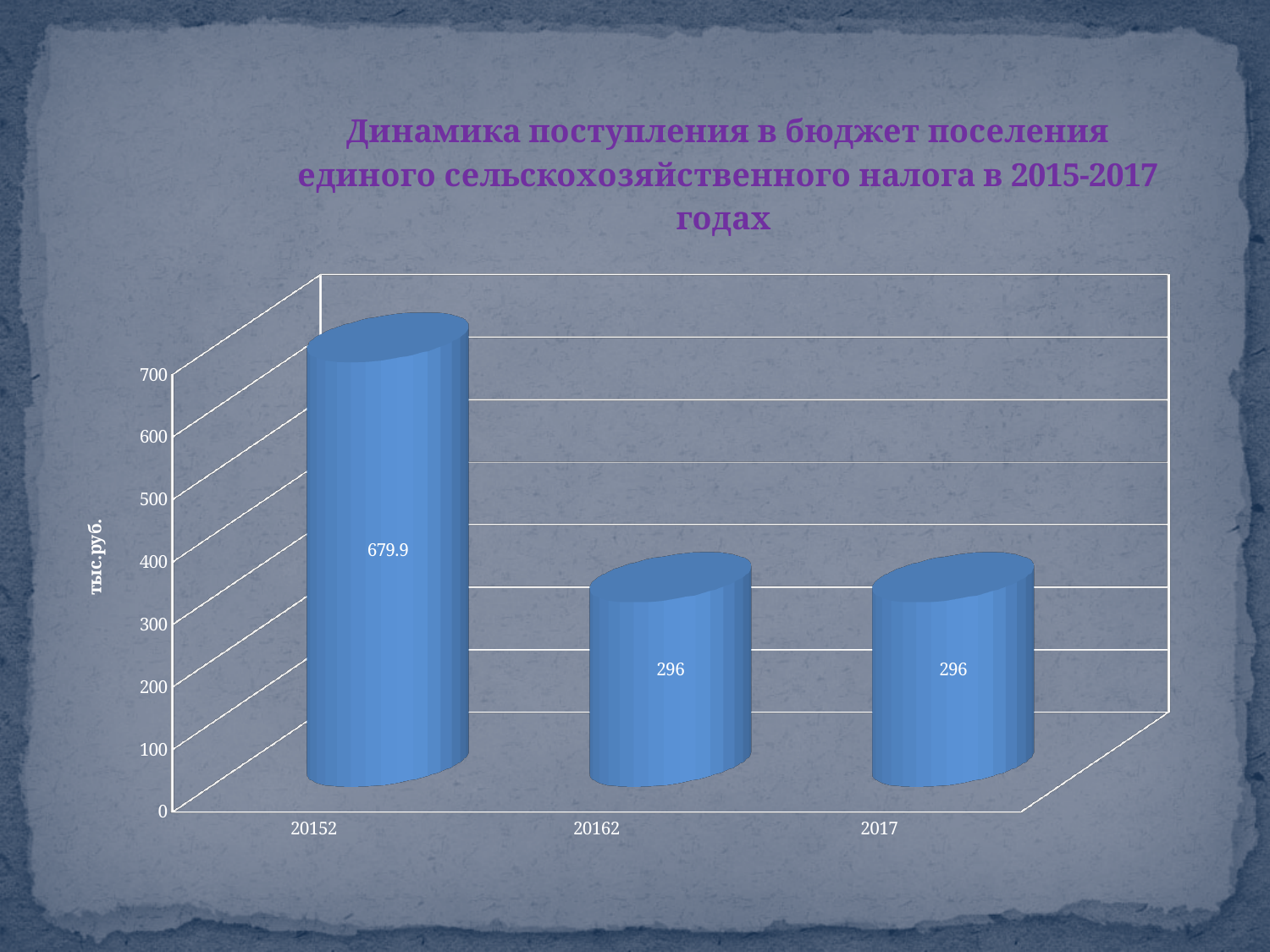
What is the value for 2017? 296 Is the value for 20162 greater or less than 400? less Do the values rise or fall from 20152 to 20162? fall What is the label on the vertical axis? тыс.руб. What is the title of the chart? Динамика поступления в бюджет поселения единого сельскохозяйственного налога в 2015-2017 годах How many categories are shown on the x axis? 3 Which category has the highest value? 20152 What is the value for 20162? 296 Which is larger, the value for 20152 or the value for 20162? 20152 What is the value for 20152? 679.9 What kind of chart is this? bar chart What is the difference between the values for 20152 and 2017? 383.9